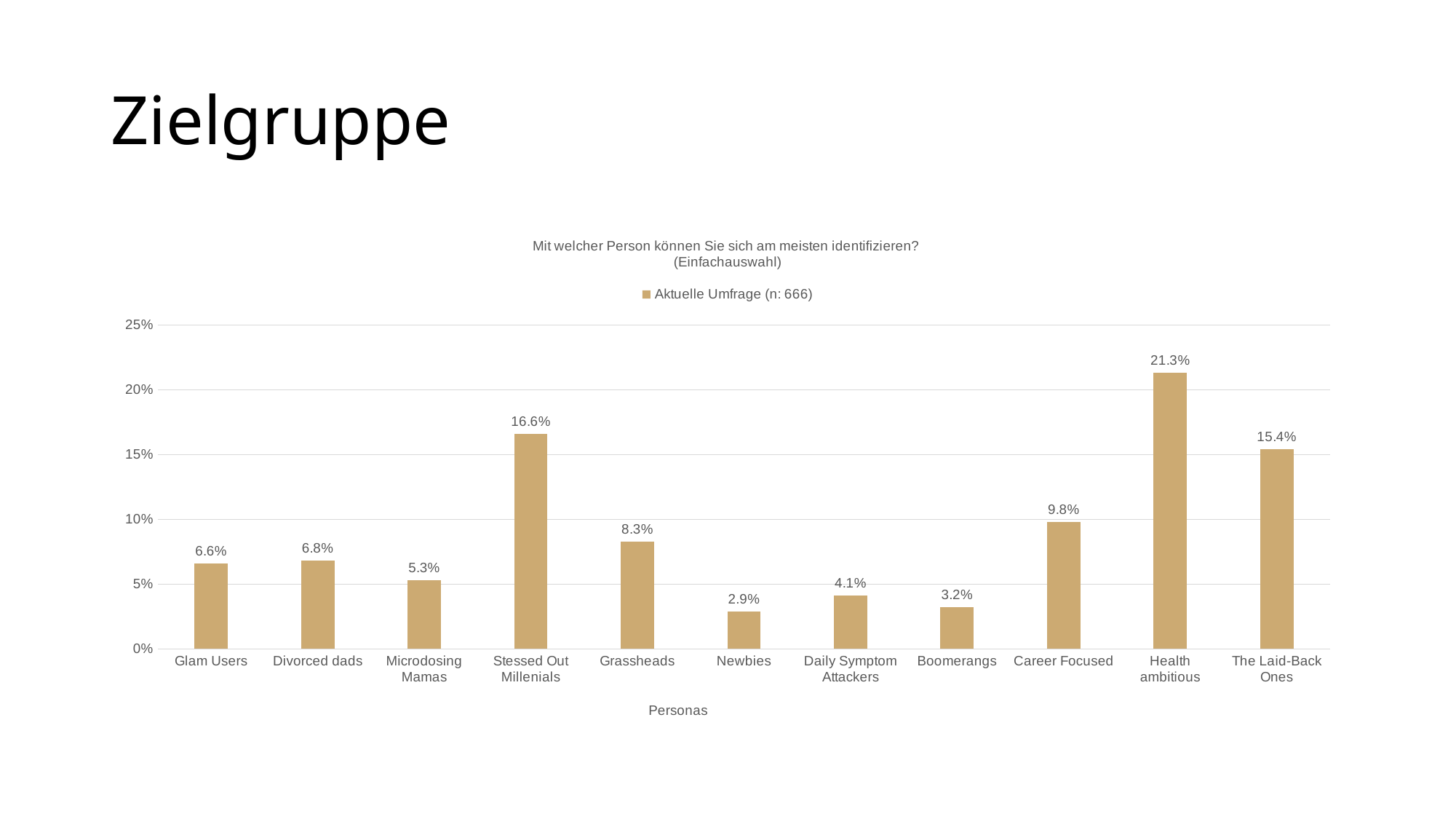
Which persona has the lowest value? Newbies How many series does the legend list? 1 What is the difference between the values for Health ambitious and The Laid-Back Ones? 5.9% What is the value for Stessed Out Millenials? 16.6% What is the legend entry of the chart? Aktuelle Umfrage (n: 666) What is the value for Newbies? 2.9% How many personas are shown on the x axis? 11 What is the value for Health ambitious? 21.3% Which is larger, the value for Career Focused or the value for Grassheads? Career Focused Is the value for Stessed Out Millenials greater or less than 15%? greater What kind of chart is shown? bar chart Which persona has the highest value? Health ambitious